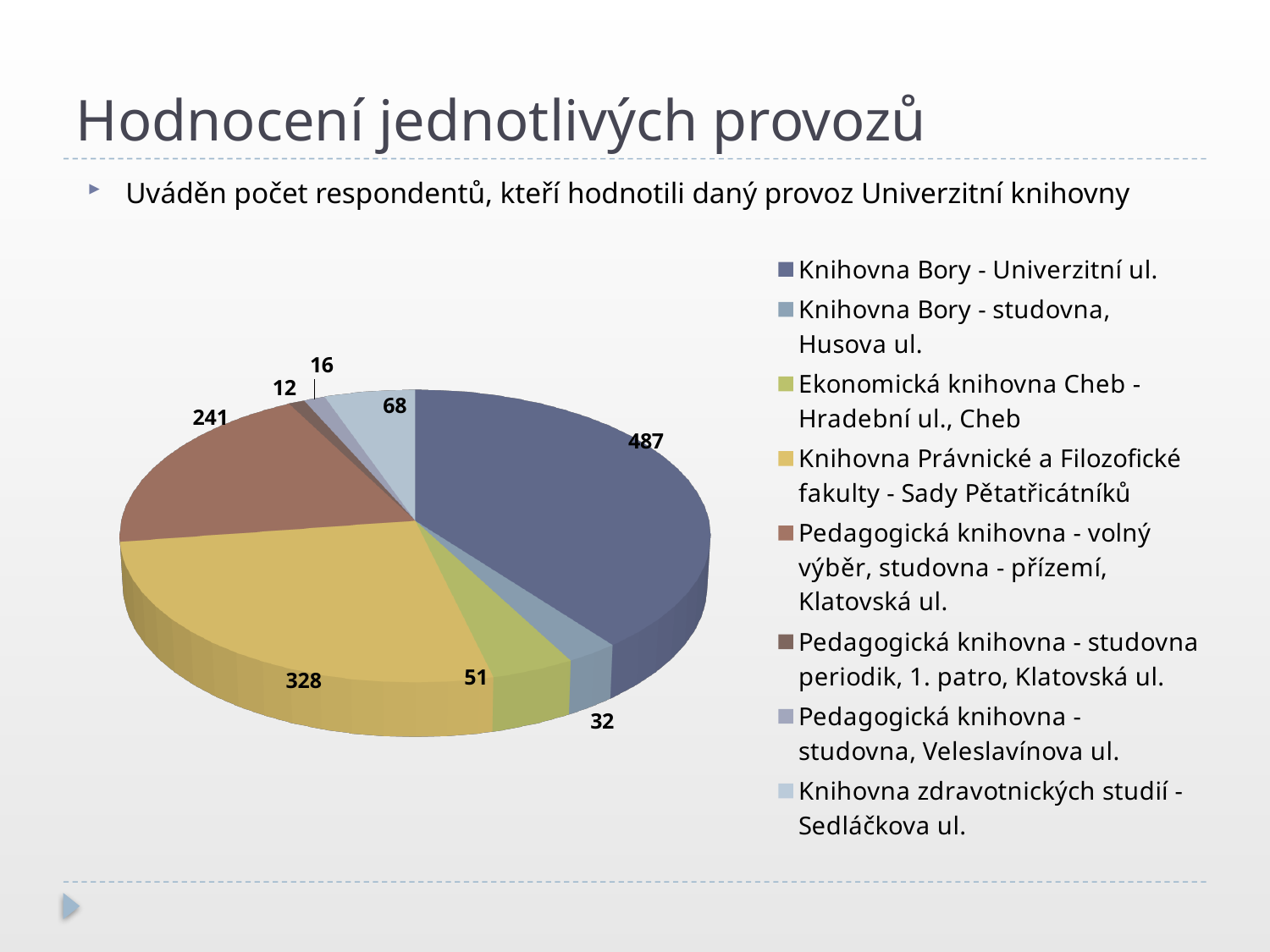
What colour is the slice for Knihovna Právnické a Filozofické fakulty - Sady Pětatřicátníků? Yellow What value is shown for Knihovna Právnické a Filozofické fakulty - Sady Pětatřicátníků? 328 Which has more respondents: Pedagogická knihovna - volný výběr, studovna - přízemí, Klatovská ul. or Knihovna zdravotnických studií - Sedláčkova ul.? Pedagogická knihovna - volný výběr, studovna - přízemí, Klatovská ul. What value is shown for Ekonomická knihovna Cheb - Hradební ul., Cheb? 51 Which library has the lowest number of respondents? Pedagogická knihovna - studovna periodik, 1. patro, Klatovská ul. What value is shown for Knihovna zdravotnických studií - Sedláčkova ul.? 68 Which library has the highest number of respondents? Knihovna Bory - Univerzitní ul. How many respondents rated Knihovna Bory - Univerzitní ul.? 487 What type of chart is shown on the slide? Pie chart How many slices does the pie chart have? 8 What is the total number of respondents across all slices of the pie chart? 1235 What is the difference between the values for Knihovna Bory - Univerzitní ul. and Knihovna Právnické a Filozofické fakulty - Sady Pětatřicátníků? 159